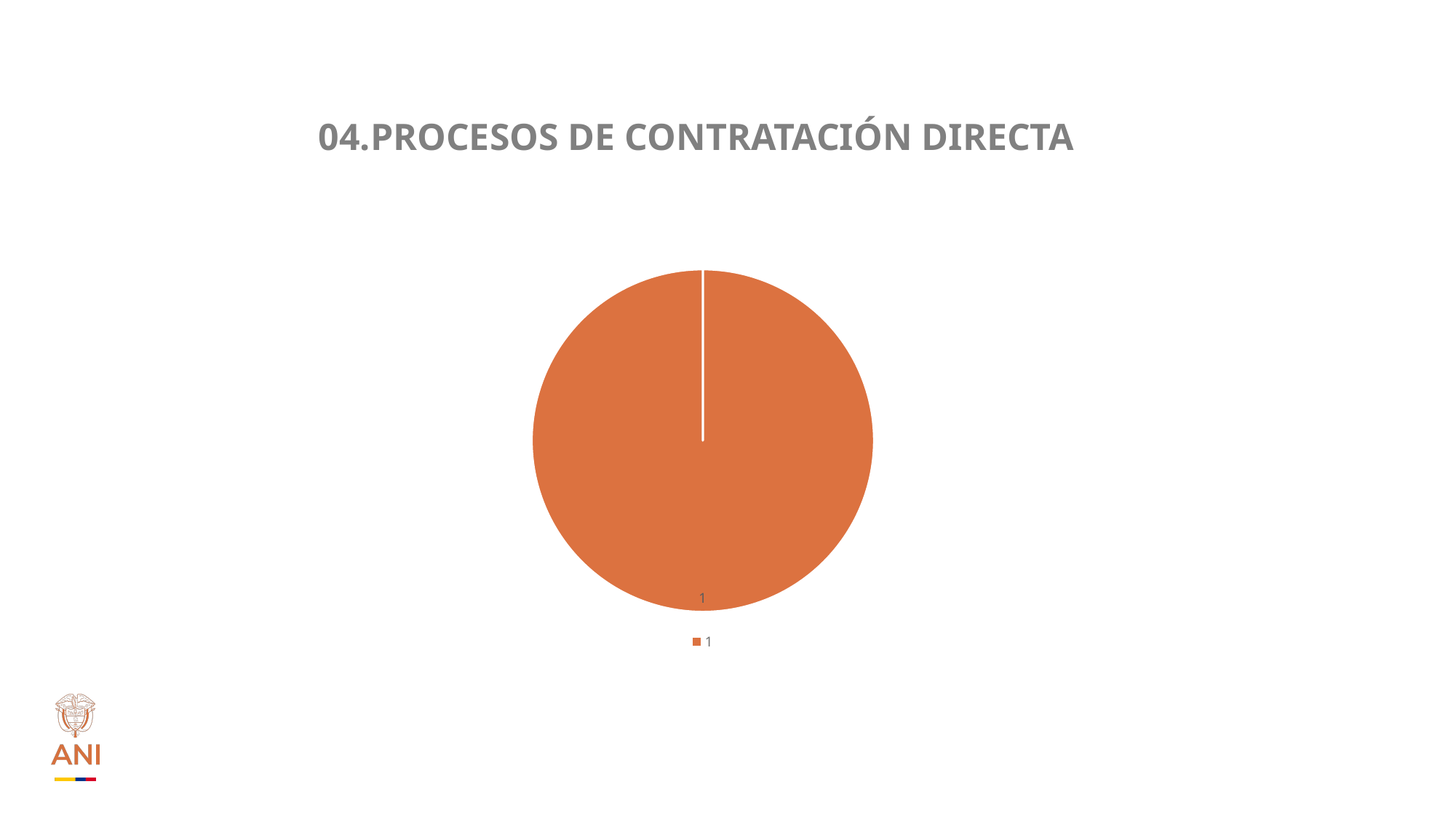
What value is printed as the data label on the pie chart's slice? 1 What colour is the slice of the pie chart? orange How many entries does the legend of the pie chart list? 1 What is the label of the entry shown in the pie chart's legend? 1 What share of the pie does the single slice represent? 100% What kind of chart is shown on the slide? pie chart How many slices does the pie chart have? 1